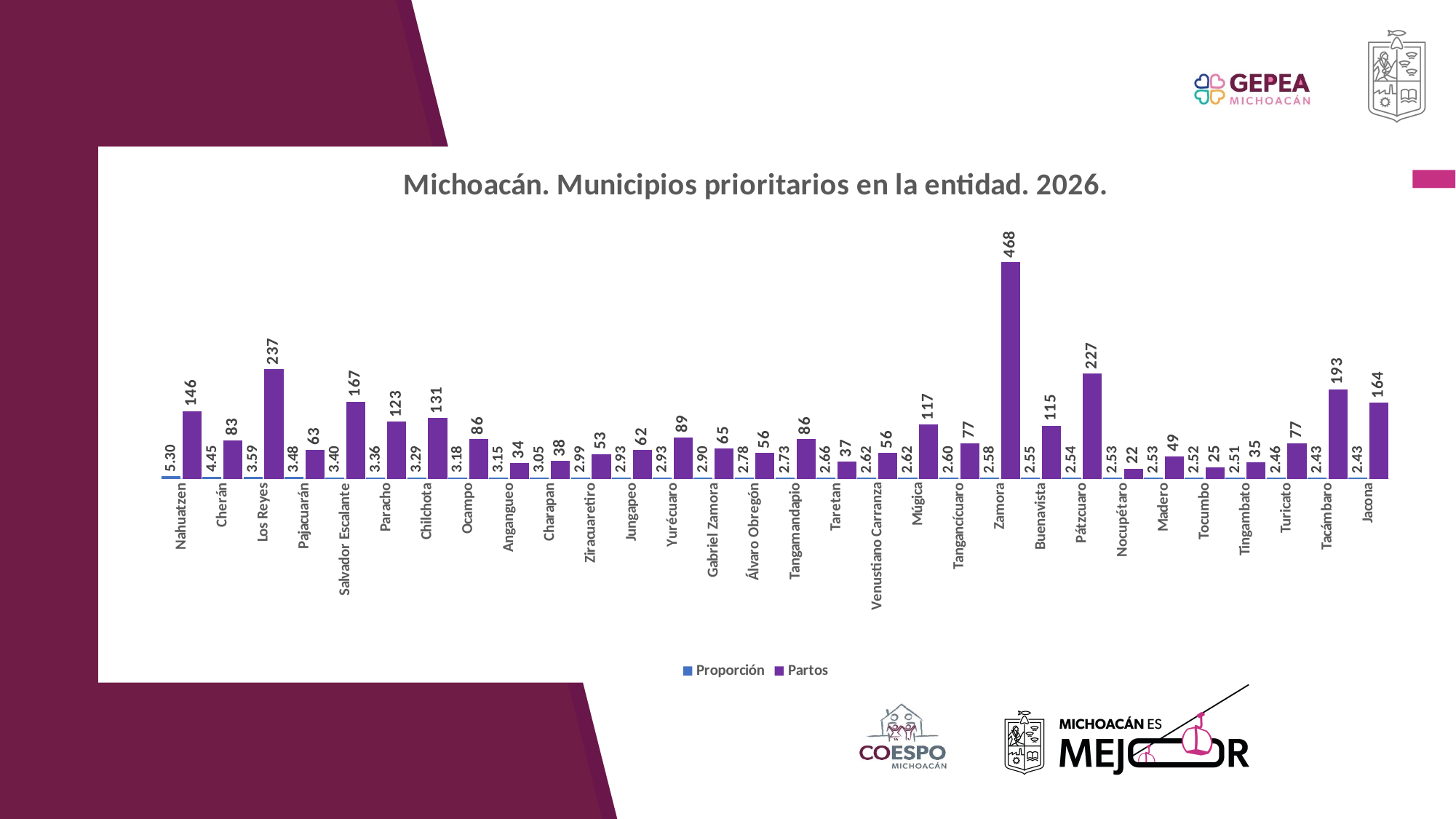
How many series does the legend list? 2 Which has a larger Partos value, Tacámbaro or Jacona? Tacámbaro How many municipalities are shown on the x axis? 30 What is the Partos value for Zamora? 468 Which municipality has the highest Proporción value? Nahuatzen Do the Proporción values rise or fall from left to right along the x axis? fall What is the Proporción value for Pátzcuaro? 2.54 Which municipality has the lowest Partos value? Nocupétaro What is the Proporción value for Nahuatzen? 5.30 What is the difference in Partos between Zamora and Pátzcuaro? 241 Which municipality has the highest Partos value? Zamora What is the Partos value for Los Reyes? 237